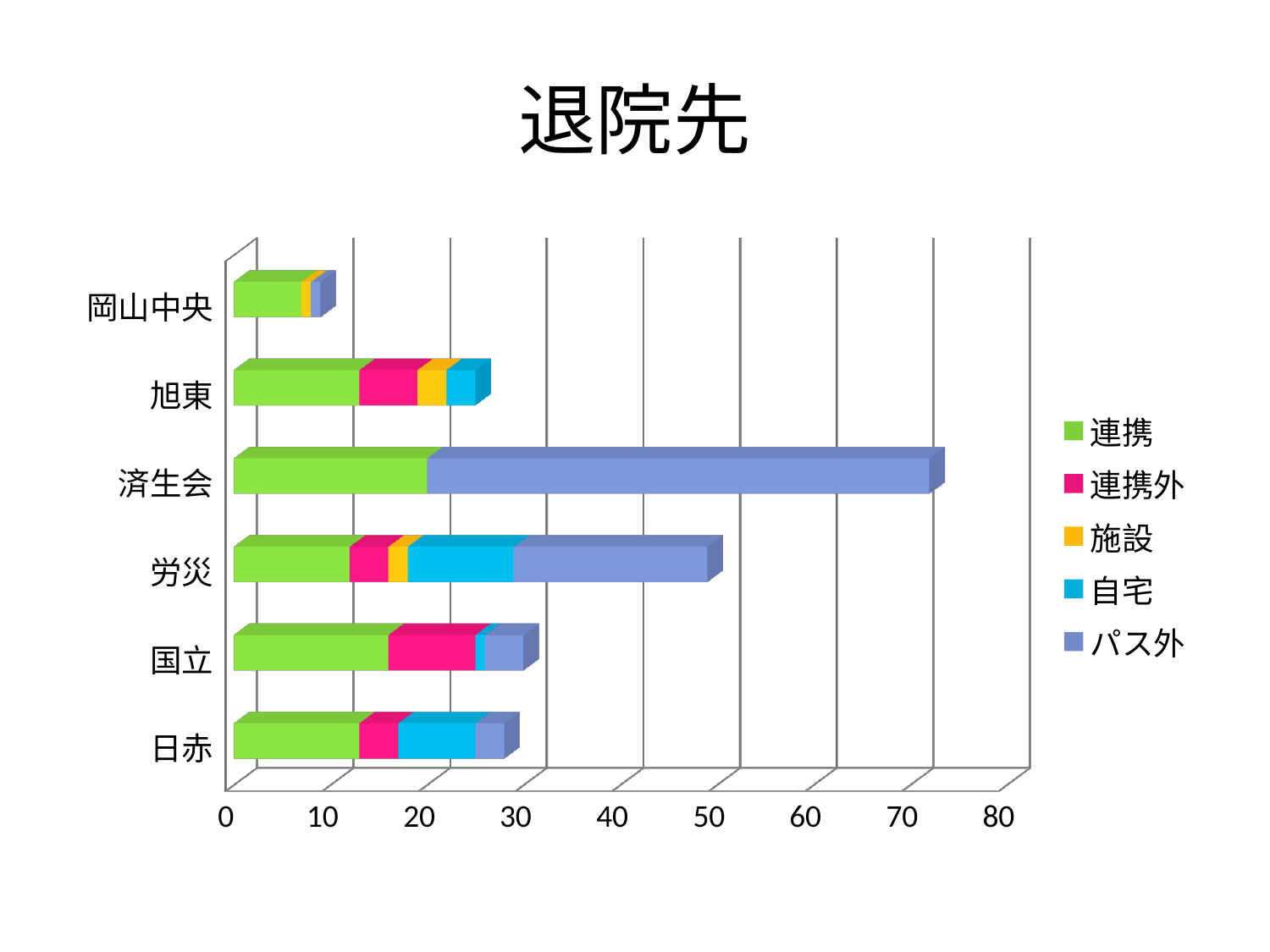
Which has the longer total bar, 岡山中央 or 旭東? 旭東 How many categories (hospitals) are shown on the chart? 6 Which has the longer total bar, 済生会 or 労災? 済生会 How many series does the legend list? 5 Which category has the shortest total bar? 岡山中央 What is the title of the chart? 退院先 What kind of chart is shown on the slide? Stacked bar chart Is the total bar length for 済生会 greater or less than 60? greater Which category has the longest total bar? 済生会 Is the total bar length for 岡山中央 greater or less than 20? less Which category has the largest 連携 segment? 済生会 Is the total bar length for 労災 greater or less than 40? greater